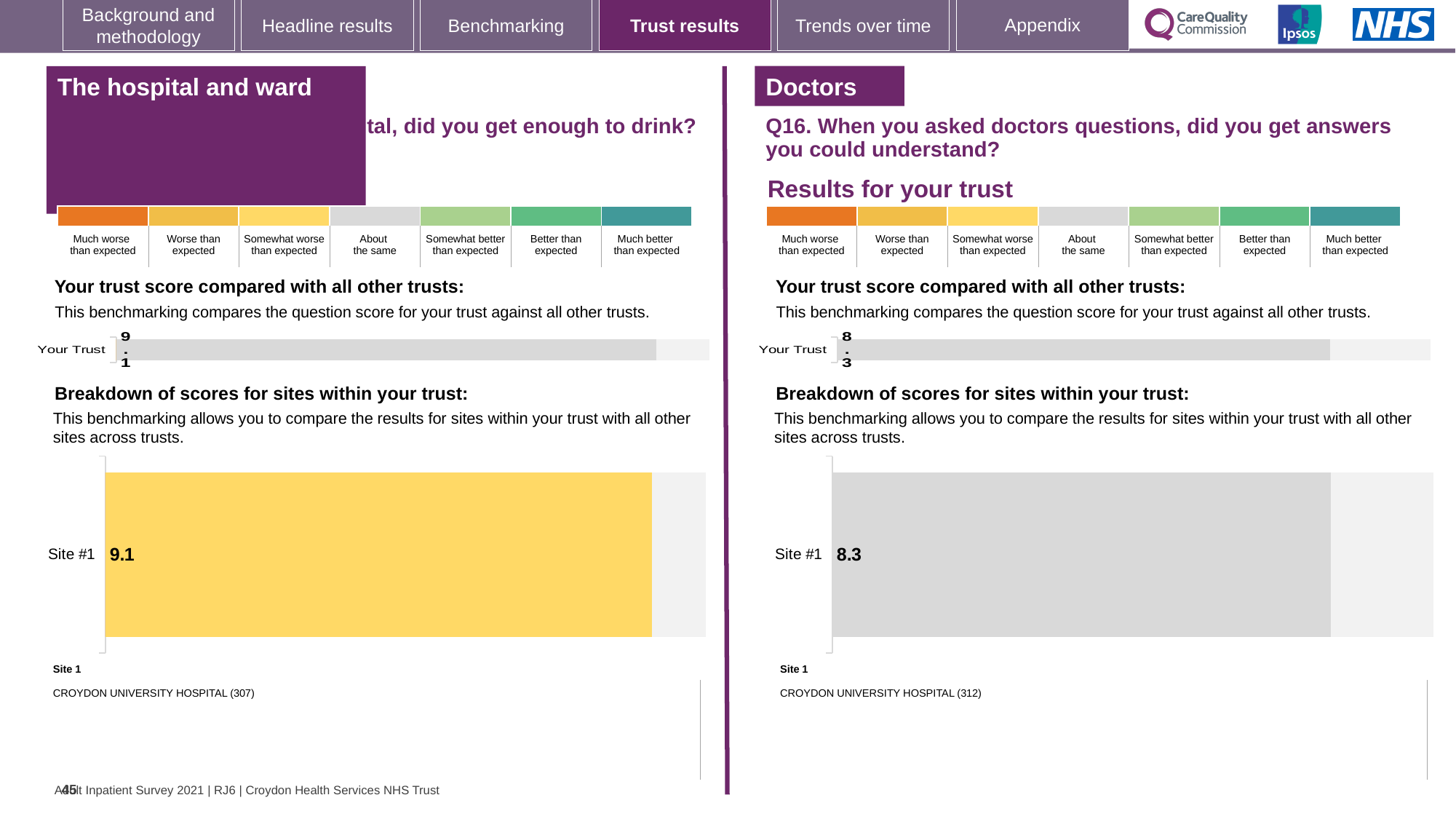
What is the difference between the Site #1 score in the left breakdown chart and the Site #1 score in the right breakdown chart? 0.8 What type of chart is used for the 'Breakdown of scores for sites within your trust' on the left half of the slide? Bar chart How many sites are shown in the left 'Breakdown of scores for sites within your trust' chart? 1 On the right half of the slide (Q16), what is the score shown for Your Trust? 8.3 In the right breakdown chart (Q16), which benchmark category does the colour of the Site #1 bar correspond to? About the same Which is larger: the Site #1 score in the left breakdown chart or the Site #1 score in the right breakdown chart? Left (9.1) How many sites are shown in the right 'Breakdown of scores for sites within your trust' chart (Q16)? 1 In the left 'Breakdown of scores for sites within your trust' chart, what is the score for Site #1? 9.1 In the left breakdown chart, which benchmark category does the colour of the Site #1 bar correspond to? Somewhat worse than expected On the left half of the slide, what is the score shown for Your Trust? 9.1 Which site name is listed as Site 1 under the right breakdown chart (Q16)? CROYDON UNIVERSITY HOSPITAL (312) In the right 'Breakdown of scores for sites within your trust' chart (Q16), what is the score for Site #1? 8.3